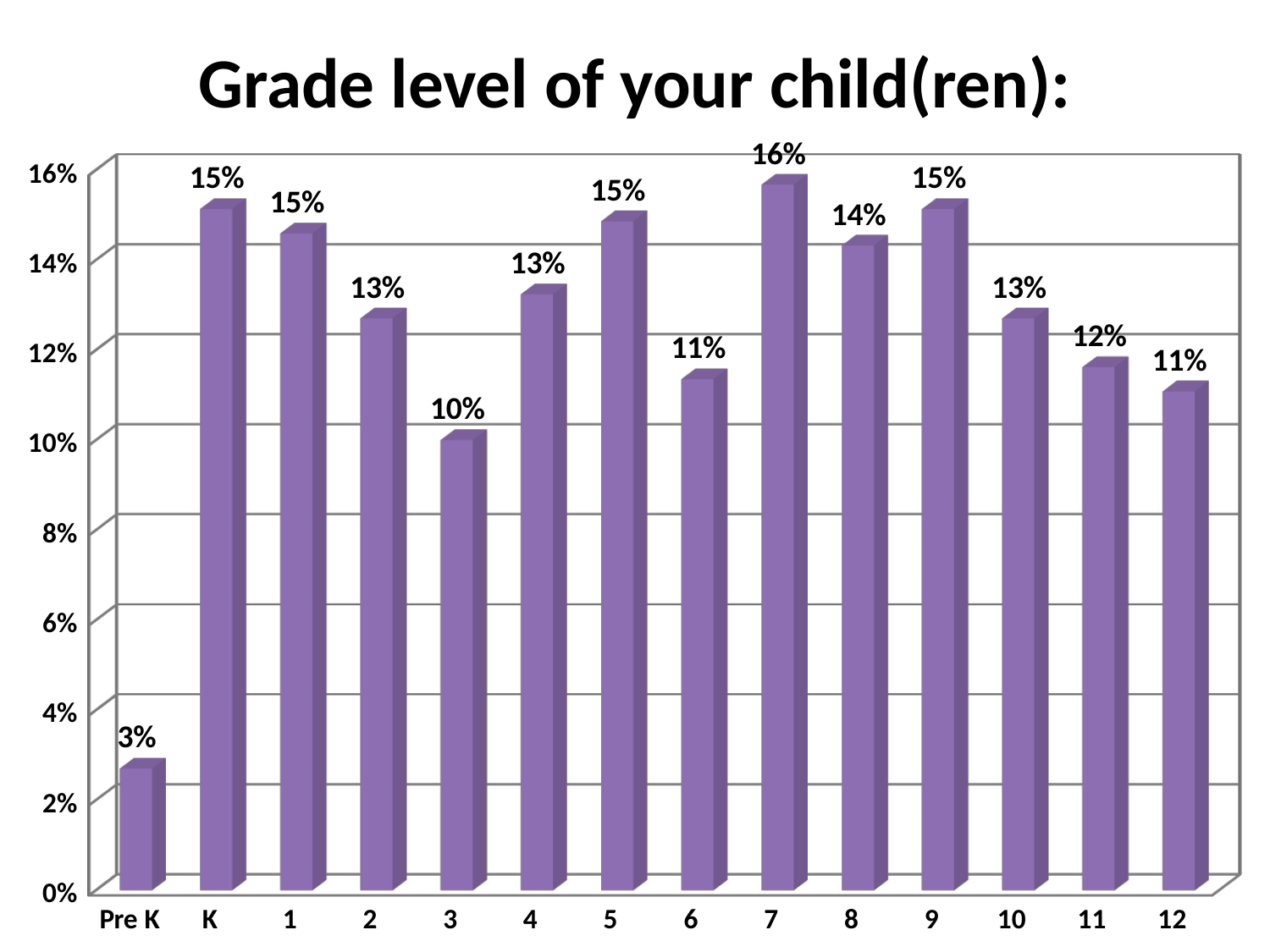
Which is larger, the value for grade 2 or the value for grade 6? grade 2 Is the value for grade 11 greater or less than 10%? greater What is the value for grade 7? 16% What is the difference between the values for grade 7 and grade 3? 6% Which grade level has the highest value? 7 Which grade level has the lowest value? Pre K How many grade level categories are shown on the x axis? 14 What kind of chart is shown on the slide? bar chart What is the value for Pre K? 3% What is the title of the chart? Grade level of your child(ren): What is the value for grade 3? 10% What is the value for grade 8? 14%